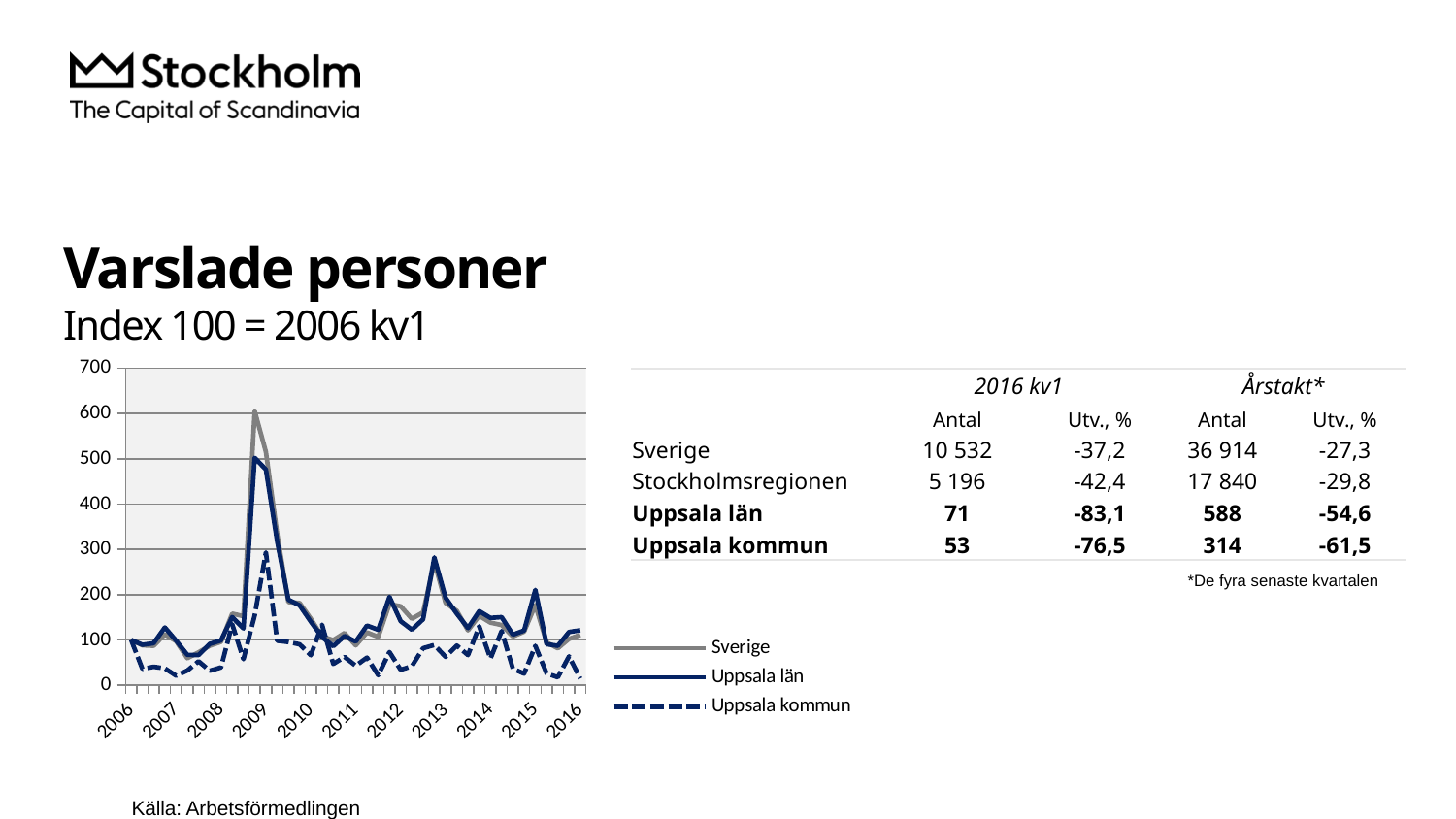
Which series are listed in the chart legend? Sverige, Uppsala län, Uppsala kommun Which series reaches the highest peak in the chart? Sverige How many series does the chart legend list? 3 Around which year do all three series reach their peak? 2009 Is the peak value for Uppsala län greater or less than 400? greater How many year labels are shown on the chart's x axis? 11 Is the peak value for Uppsala kommun greater or less than 200? greater What kind of chart is shown on the slide? line chart What is the highest value shown on the chart's vertical axis? 700 Is the value for Uppsala kommun at the end of the series in 2016 greater or less than 100? less